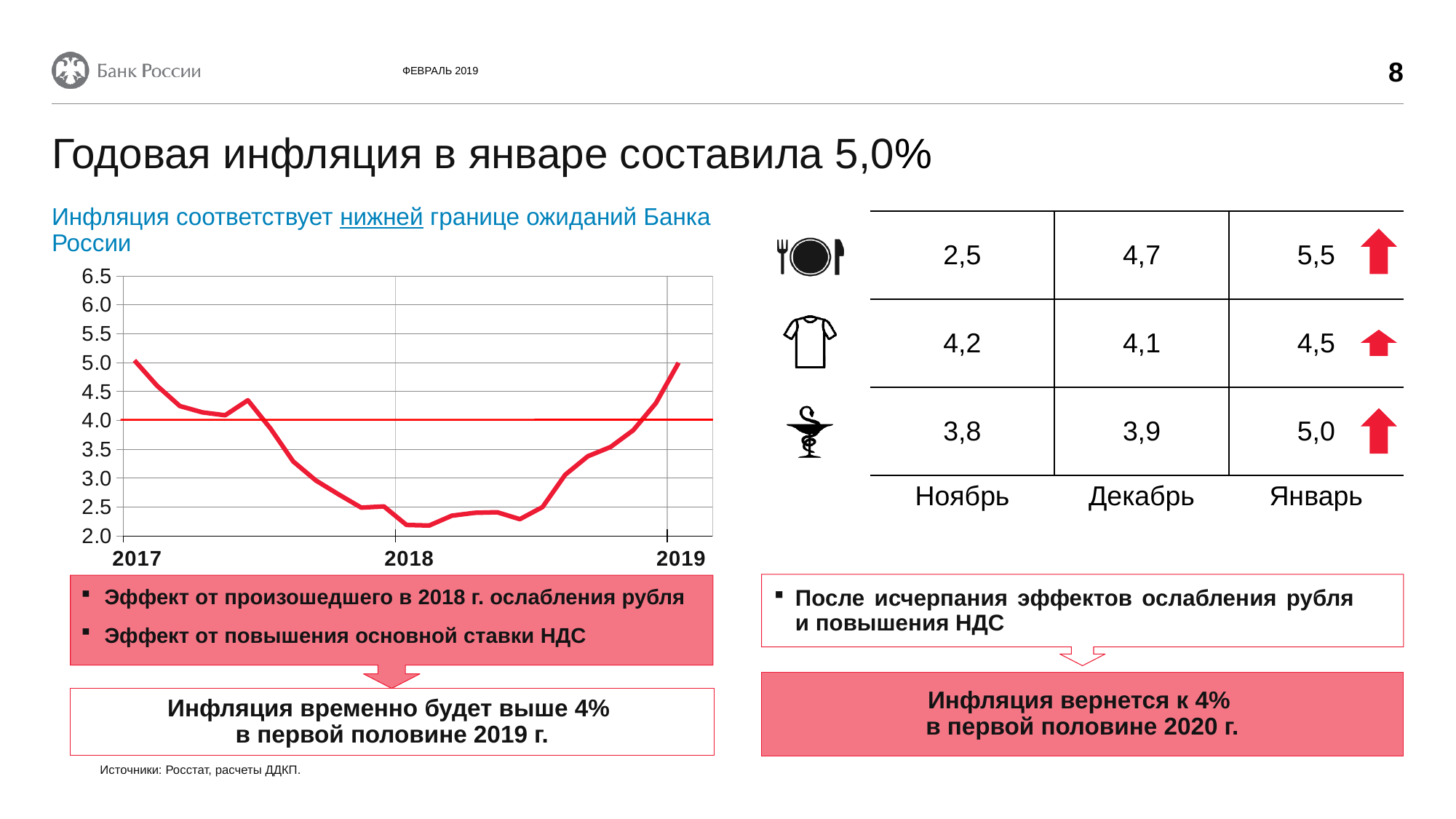
At what level is the horizontal reference line drawn in the line chart? 4.0 In the line chart, is the value at the 2018 mark greater or less than 3.0? less In the line chart, which is larger: the value at the 2017 mark or the value at the 2018 mark? 2017 In the line chart, does the inflation line rise or fall between the 2017 and 2018 marks on the x axis? fall In the line chart, is the value at the start of 2017 greater or less than 4.5? greater How many year labels are shown on the x axis of the line chart? 3 What is the highest value shown on the y axis of the line chart? 6.5 In the line chart, does the inflation line rise or fall between the 2018 and 2019 marks on the x axis? rise In the line chart, is the value at the 2019 mark greater or less than 4.5? greater What kind of chart is shown on the left of the slide? line chart